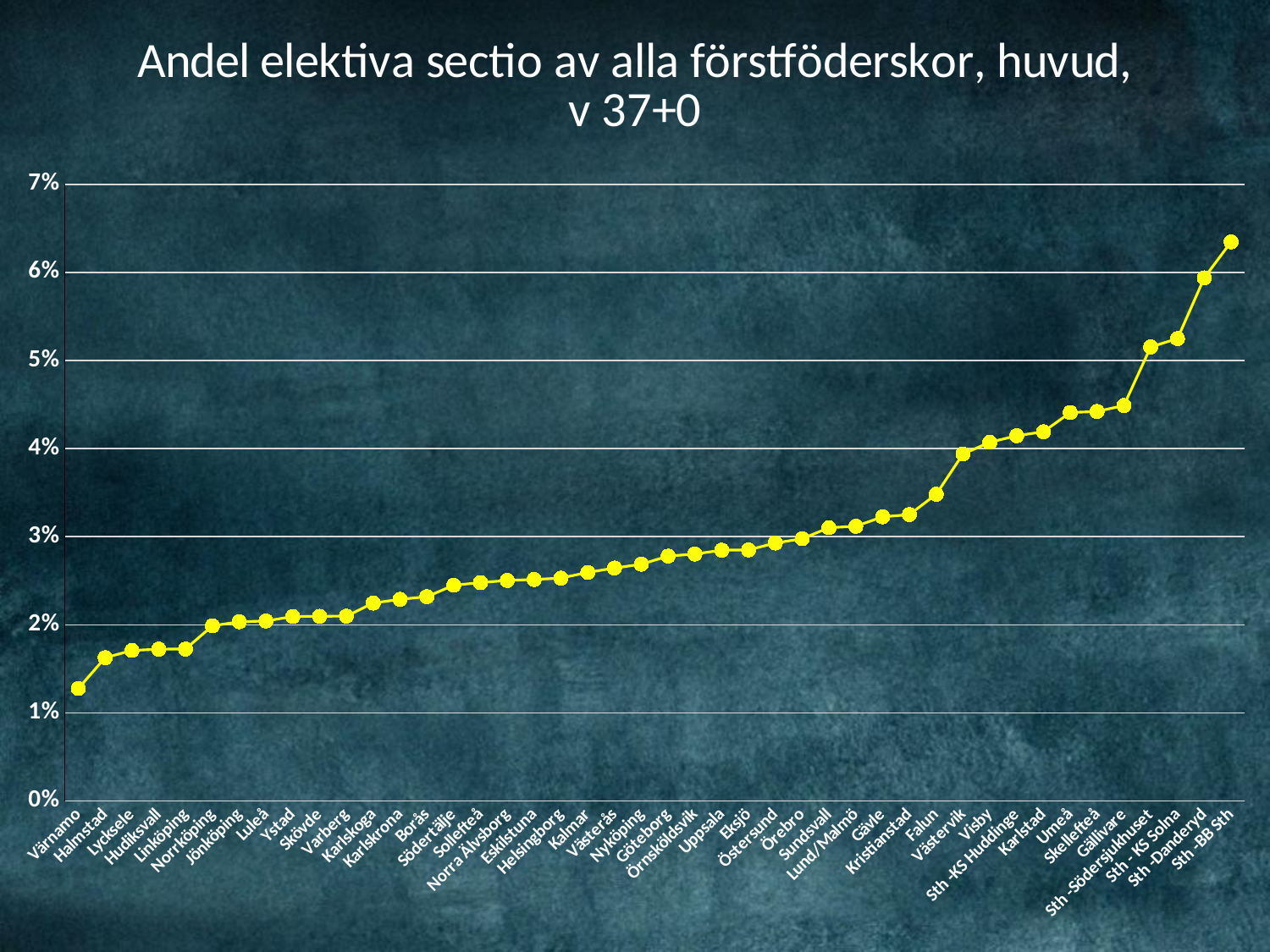
Is the value for Gällivare greater or less than 4%? greater Which hospital has the lowest value in the chart? Värnamo Is the value for Falun greater or less than 3%? greater What kind of chart is shown on the slide? line chart What is the title of the chart? Andel elektiva sectio av alla förstföderskor, huvud, v 37+0 Which has the larger value, Halmstad or Karlstad? Karlstad Is the value for Sth -BB Sth greater or less than 6%? greater Do the values rise or fall from left to right along the x axis? rise Which has the larger value, Falun or Borås? Falun Which hospital has the highest value in the chart? Sth -BB Sth